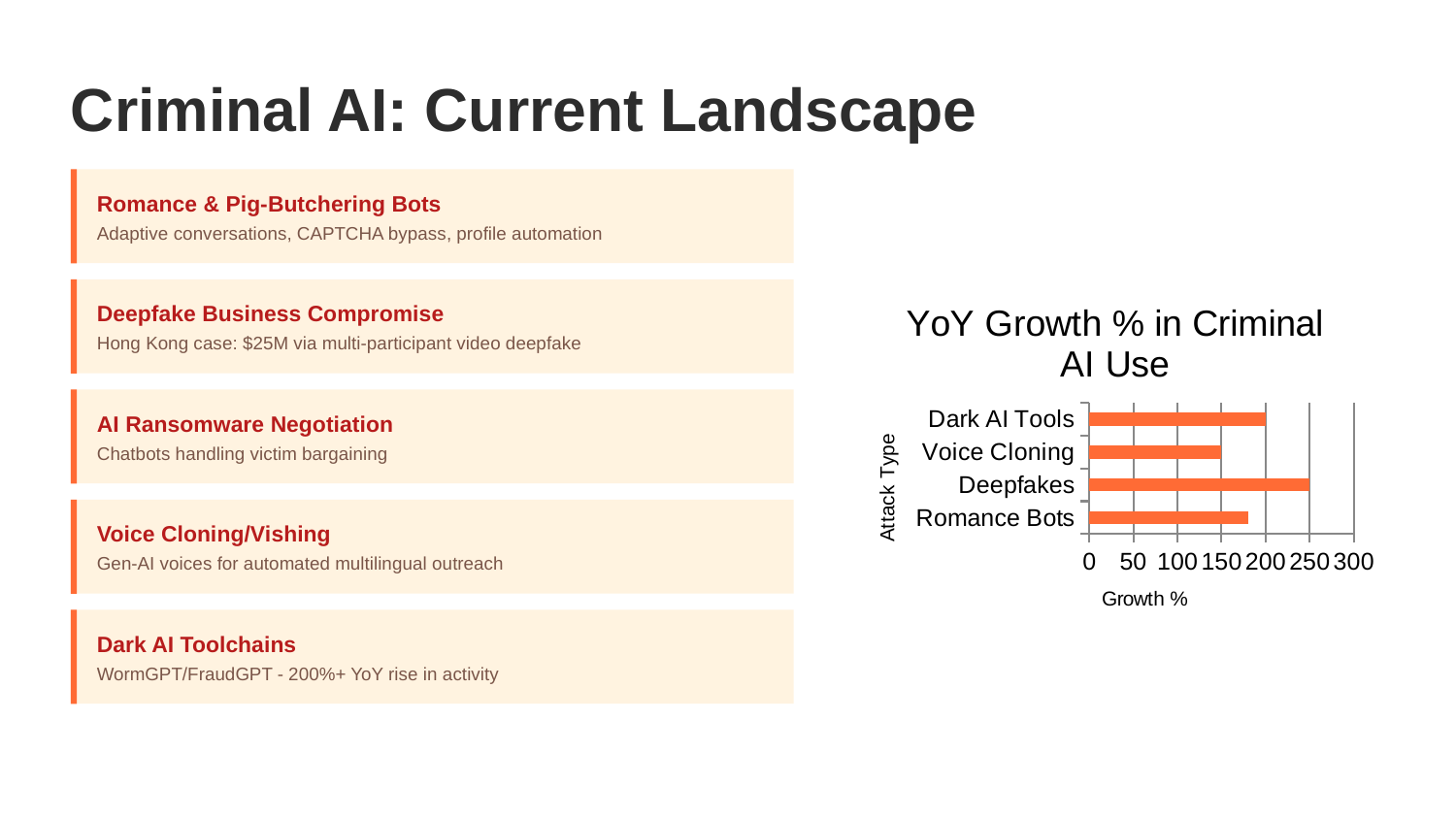
Which has a higher YoY growth %, Dark AI Tools or Romance Bots? Dark AI Tools What is the YoY growth % for Voice Cloning in the chart? 150 How many attack types are plotted in the YoY Growth % in Criminal AI Use chart? 4 What is the title of the chart on the slide? YoY Growth % in Criminal AI Use What is the label on the horizontal axis of the chart? Growth % What type of chart is shown on the slide? Bar chart Is the value for Romance Bots greater or less than 200? less Is the value for Romance Bots greater or less than 150? greater What is the YoY growth % for Deepfakes in the chart? 250 Which attack type has the lowest YoY growth % in the chart? Voice Cloning What is the YoY growth % for Dark AI Tools in the chart? 200 Which attack type has the highest YoY growth % in the chart? Deepfakes